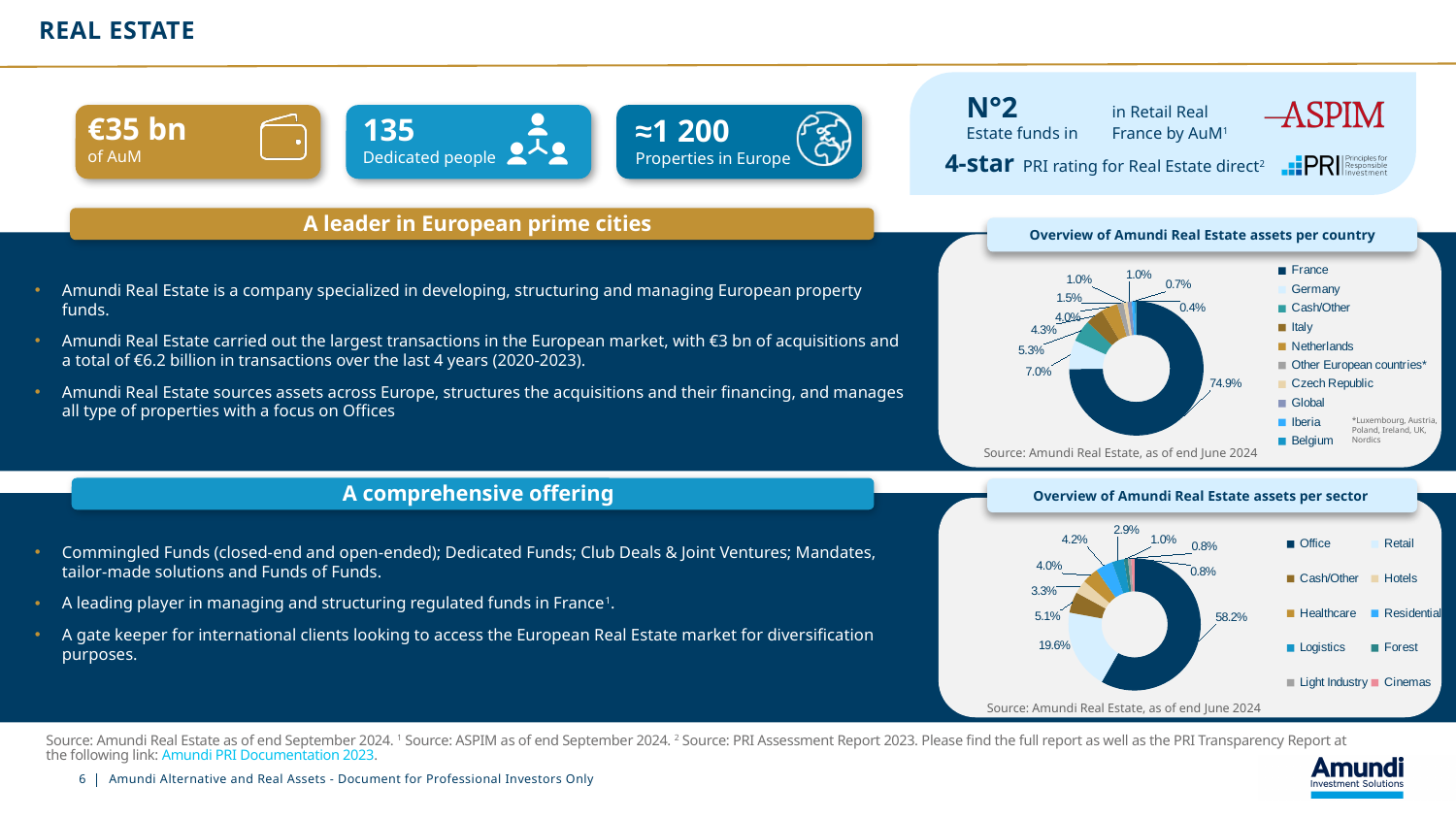
On the 'Overview of Amundi Real Estate assets per country' chart, what share of assets is in Germany? 7.0% What kind of chart is the 'Overview of Amundi Real Estate assets per country' chart? Doughnut (pie) chart On the 'Overview of Amundi Real Estate assets per sector' chart, what is the difference in percentage points between Office and Retail? 38.6 On the 'Overview of Amundi Real Estate assets per sector' chart, which is larger, Office or Retail? Office What source is cited below the 'Overview of Amundi Real Estate assets per sector' chart? Amundi Real Estate, as of end June 2024 On the 'Overview of Amundi Real Estate assets per country' chart, what share of assets is in France? 74.9% On the 'Overview of Amundi Real Estate assets per country' chart, how many categories does the legend list? 10 On the 'Overview of Amundi Real Estate assets per country' chart, what is the difference in percentage points between France and Germany? 67.9 On the 'Overview of Amundi Real Estate assets per country' chart, which country has the largest share? France On the 'Overview of Amundi Real Estate assets per sector' chart, which sector has the largest share? Office On the 'Overview of Amundi Real Estate assets per sector' chart, what share of assets is in Office? 58.2% On the 'Overview of Amundi Real Estate assets per sector' chart, what share of assets is in Retail? 19.6%